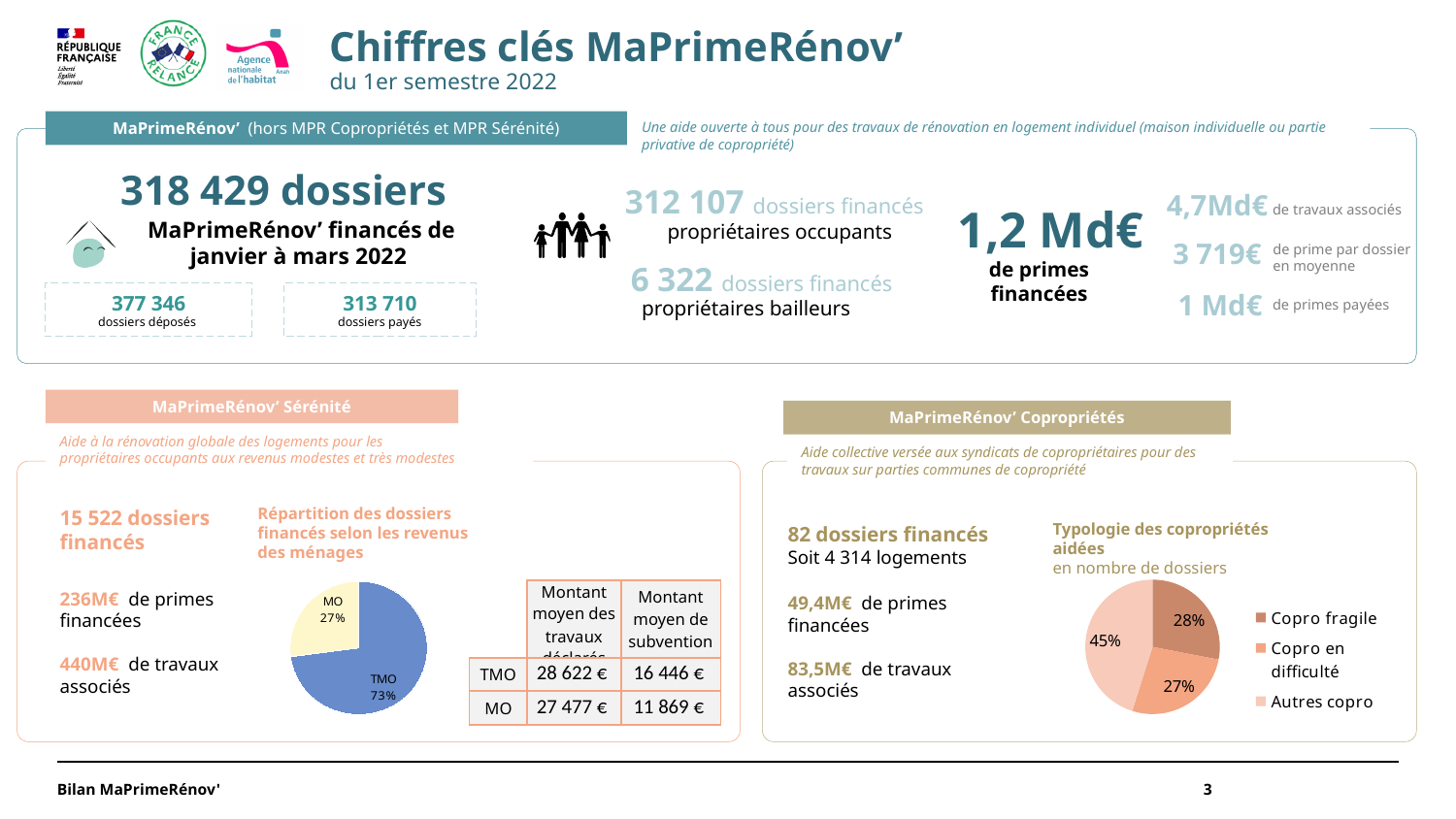
In the pie chart 'Répartition des dossiers financés selon les revenus des ménages', what share is labelled MO? 27% In the pie chart 'Typologie des copropriétés aidées', what share is 'Copro en difficulté'? 27% In the pie chart 'Répartition des dossiers financés selon les revenus des ménages', which category has the largest share? TMO How many categories does the legend of the pie chart 'Typologie des copropriétés aidées' list? 3 In the pie chart 'Typologie des copropriétés aidées', what share is 'Copro fragile'? 28% In the pie chart 'Répartition des dossiers financés selon les revenus des ménages', what is the difference between the TMO and MO shares? 46 percentage points In the pie chart 'Typologie des copropriétés aidées', which category has the largest share? Autres copro In the pie chart 'Typologie des copropriétés aidées', what share is 'Autres copro'? 45% How many slices does the pie chart 'Répartition des dossiers financés selon les revenus des ménages' have? 2 In the pie chart 'Typologie des copropriétés aidées', which category has the smallest share? Copro en difficulté In the pie chart 'Répartition des dossiers financés selon les revenus des ménages', what share is labelled TMO? 73% What type of chart is used for 'Typologie des copropriétés aidées'? Pie chart